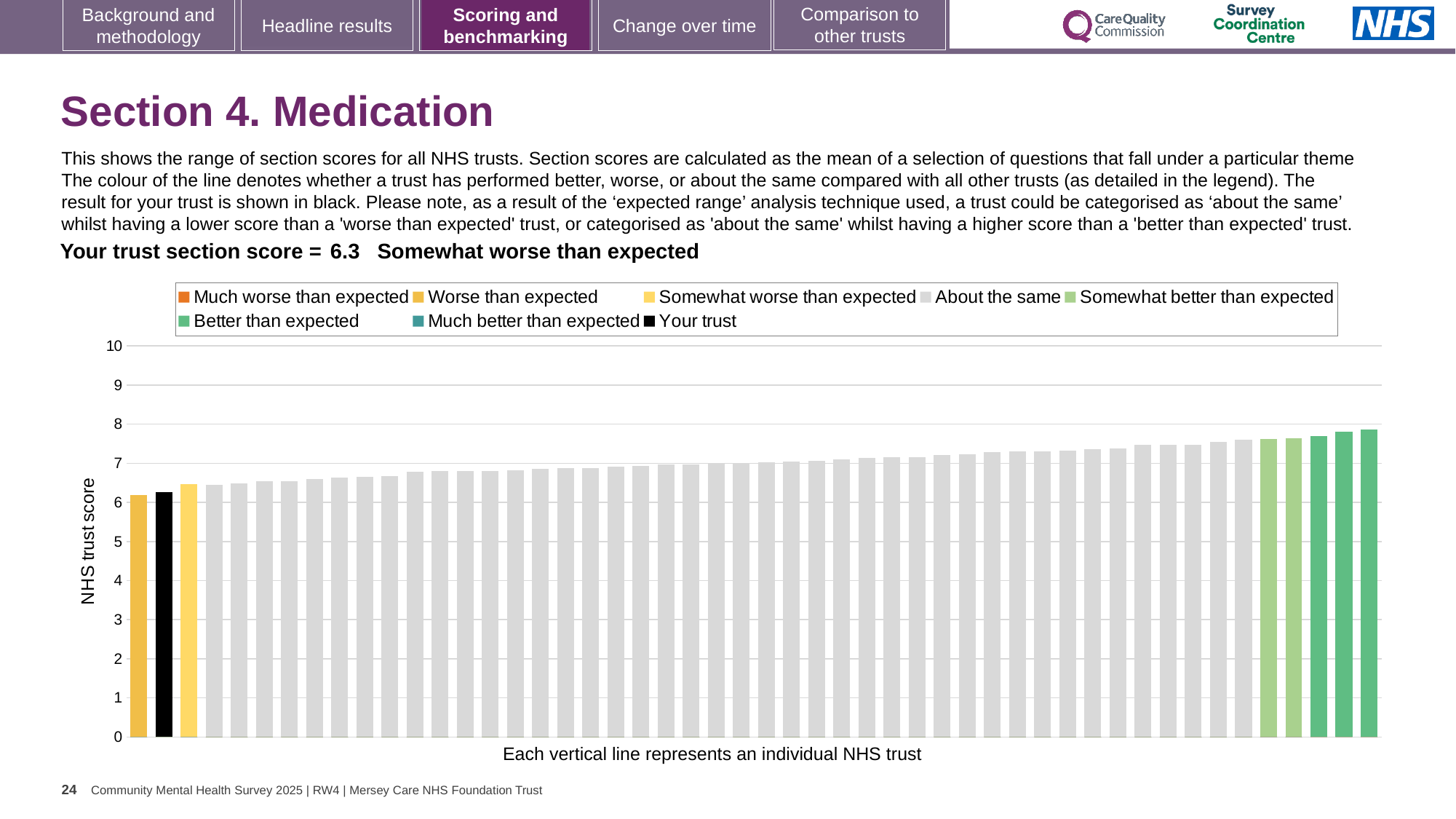
Is the value of the black 'Your trust' bar greater or less than 5? greater What is the title of the vertical axis? NHS trust score What kind of chart is shown on the slide? bar chart How many bars are coloured as 'Better than expected' (dark green)? 3 How many entries does the chart legend list? 8 What is the section score for your trust shown on the slide? 6.3 Which is larger, the leftmost bar or the rightmost bar? the rightmost bar Is the value of the tallest bar greater or less than 7? greater Do the bar values rise or fall from left to right along the x axis? rise How many bars are coloured as 'Somewhat better than expected' (light green)? 2 Is the value of the leftmost bar greater or less than 7? less Which legend category is your trust placed in for this section? Somewhat worse than expected